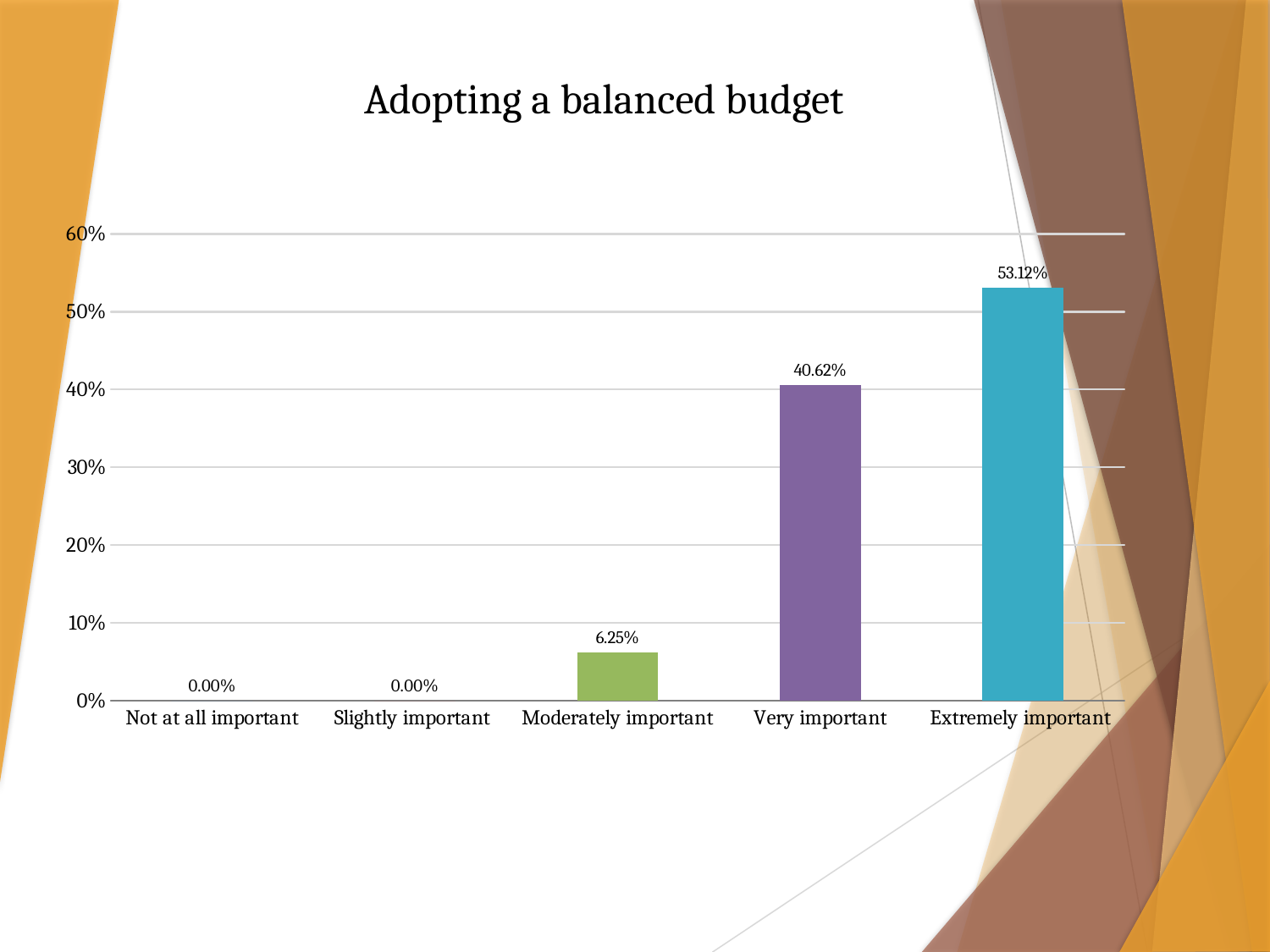
Which category has the highest value? Extremely important How many categories are shown on the x axis? 5 Which is larger, the value for Very important or the value for Moderately important? Very important What is the value for Very important? 40.62% What is the difference between the values for Very important and Moderately important? 34.37% Is the value for Extremely important greater or less than 50%? greater What is the value for Slightly important? 0.00% What is the value for Extremely important? 53.12% What is the difference between the values for Extremely important and Very important? 12.50% What kind of chart is shown on the slide? Bar chart What is the title of the chart? Adopting a balanced budget What is the value for Moderately important? 6.25%